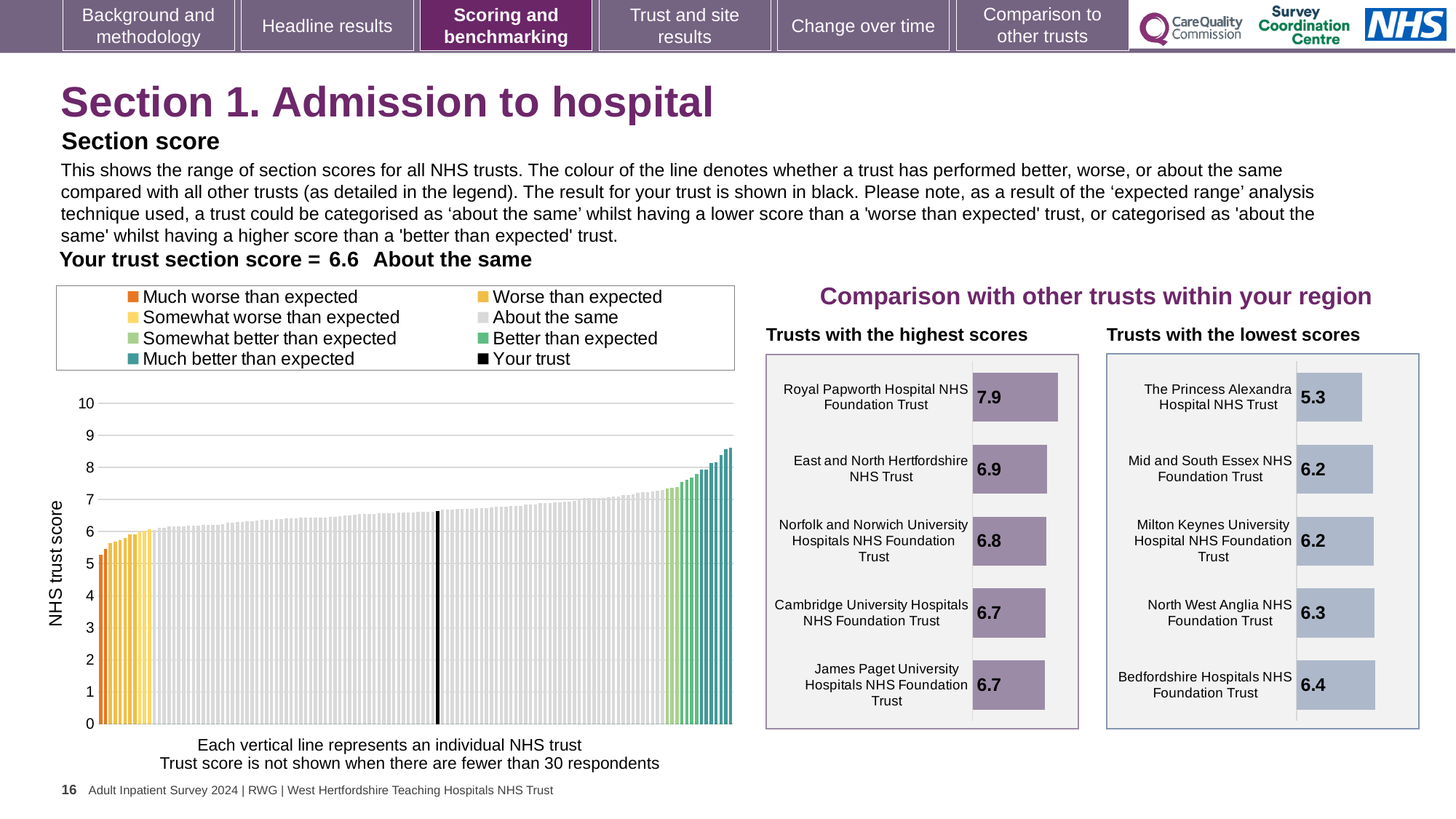
In the main NHS trust score chart on the left, is the value of the tallest bar greater or less than 8? greater In the 'Trusts with the lowest scores' chart, how many trusts are shown? 5 In the 'Trusts with the lowest scores' chart, which has the higher score: North West Anglia NHS Foundation Trust or Bedfordshire Hospitals NHS Foundation Trust? Bedfordshire Hospitals NHS Foundation Trust In the main NHS trust score chart on the left, how many entries does the legend list? 8 In the 'Trusts with the highest scores' chart, what is the score for Royal Papworth Hospital NHS Foundation Trust? 7.9 In the 'Trusts with the highest scores' chart, what is the difference between the scores of Royal Papworth Hospital NHS Foundation Trust and East and North Hertfordshire NHS Trust? 1.0 In the 'Trusts with the lowest scores' chart, what is the score for The Princess Alexandra Hospital NHS Trust? 5.3 In the 'Trusts with the highest scores' chart, what is the score for Norfolk and Norwich University Hospitals NHS Foundation Trust? 6.8 In the main NHS trust score chart on the left, do the bars rise or fall from left to right? Rise In the 'Trusts with the highest scores' chart, which trust has the highest score? Royal Papworth Hospital NHS Foundation Trust What kind of chart is the main NHS trust score chart on the left? Bar chart In the 'Trusts with the lowest scores' chart, which trust has the lowest score? The Princess Alexandra Hospital NHS Trust